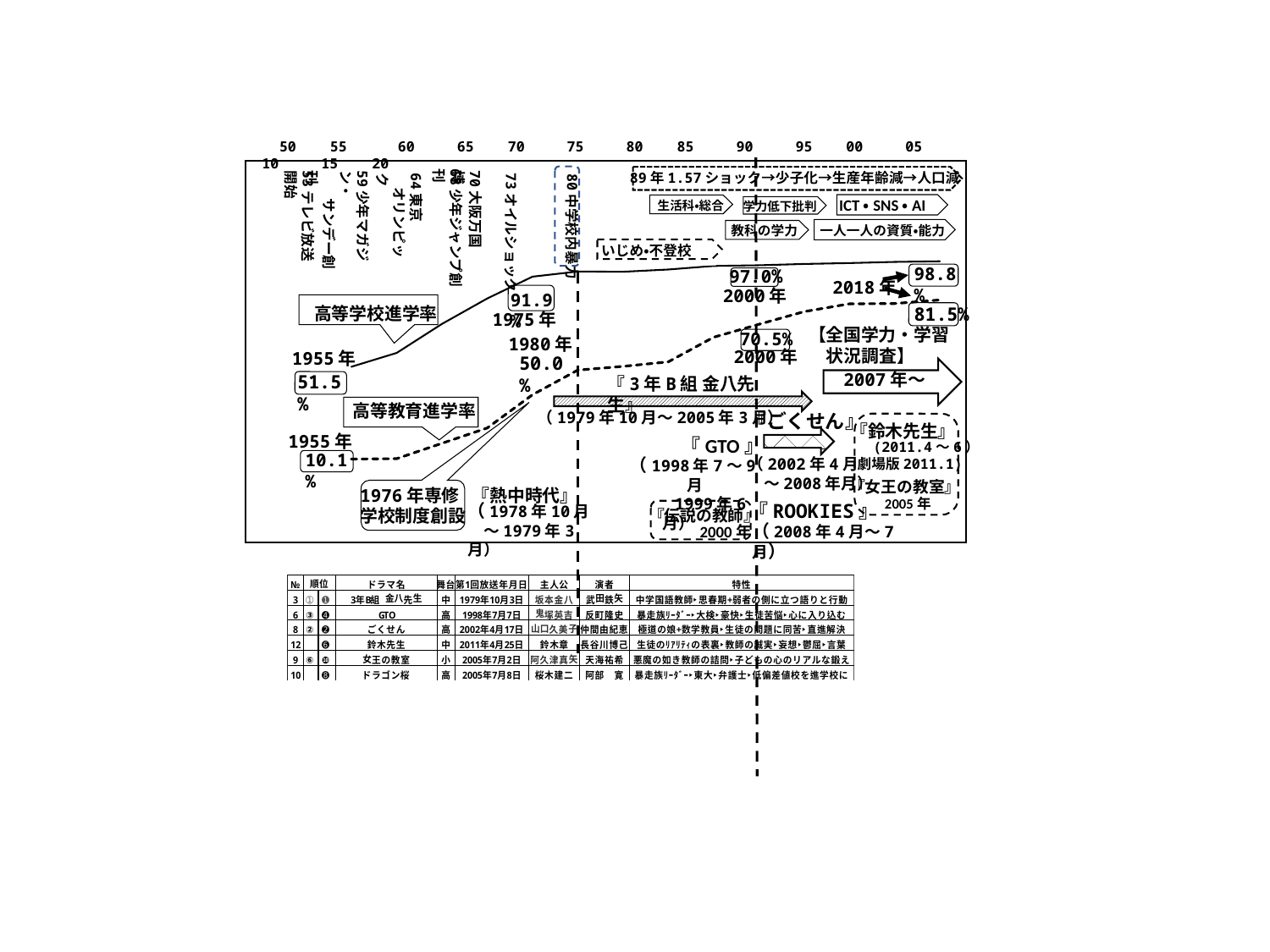
What is the 高等教育進学率 value labelled for 2018年? 81.5% What kind of chart is used to show the 高等学校進学率 and 高等教育進学率 over time? line chart In 1955年, which rate is higher: 高等学校進学率 or 高等教育進学率? 高等学校進学率 What is the 高等教育進学率 value labelled for 1980年? 50.0% Does the 高等教育進学率 line rise or fall from 1955年 to 2018年? rise What is the 高等学校進学率 value labelled for 2000年? 97.0% In 2000年, how many percentage points higher is the 高等学校進学率 than the 高等教育進学率? 26.5 What is the 高等教育進学率 (higher education enrollment rate) shown for 1955年? 10.1% What is the 高等教育進学率 value labelled for 2000年? 70.5% What is the 高等学校進学率 (high school enrollment rate) shown for 1955年? 51.5% What is the 高等学校進学率 value labelled for 2018年? 98.8% What is the 高等学校進学率 value labelled for 1975年? 91.9%